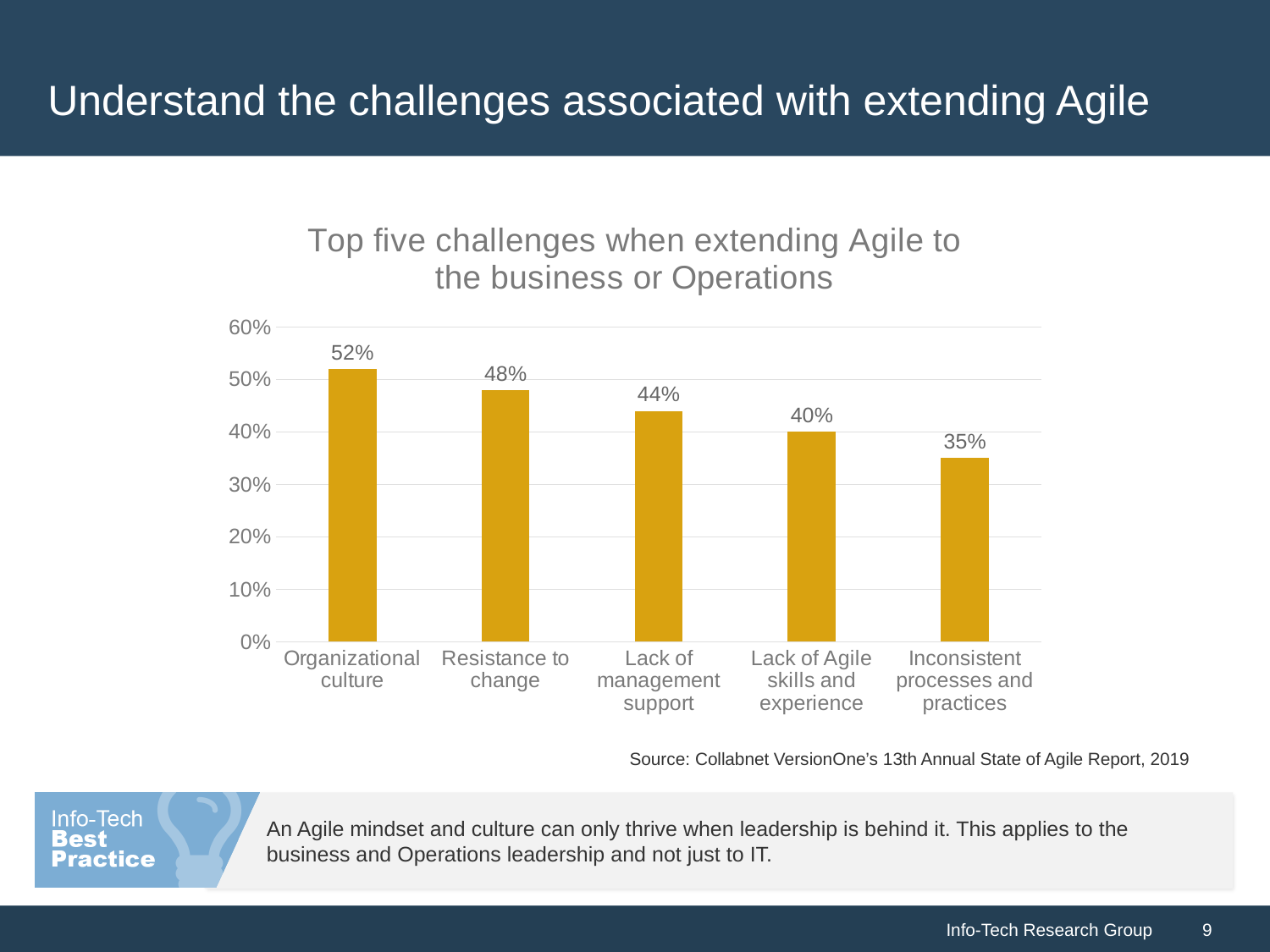
What is the difference between the values for Lack of Agile skills and experience and Inconsistent processes and practices? 5% How many challenges are shown in the chart? 5 Is the value for Lack of management support greater or less than 50%? less What is the value for Organizational culture? 52% Which is larger, the value for Resistance to change or the value for Lack of Agile skills and experience? Resistance to change What is the value for Lack of management support? 44% Do the values rise or fall from left to right across the chart? fall Which challenge has the highest value? Organizational culture What is the difference between the values for Organizational culture and Resistance to change? 4% Which challenge has the lowest value? Inconsistent processes and practices What kind of chart is shown on the slide? bar chart What is the value for Inconsistent processes and practices? 35%